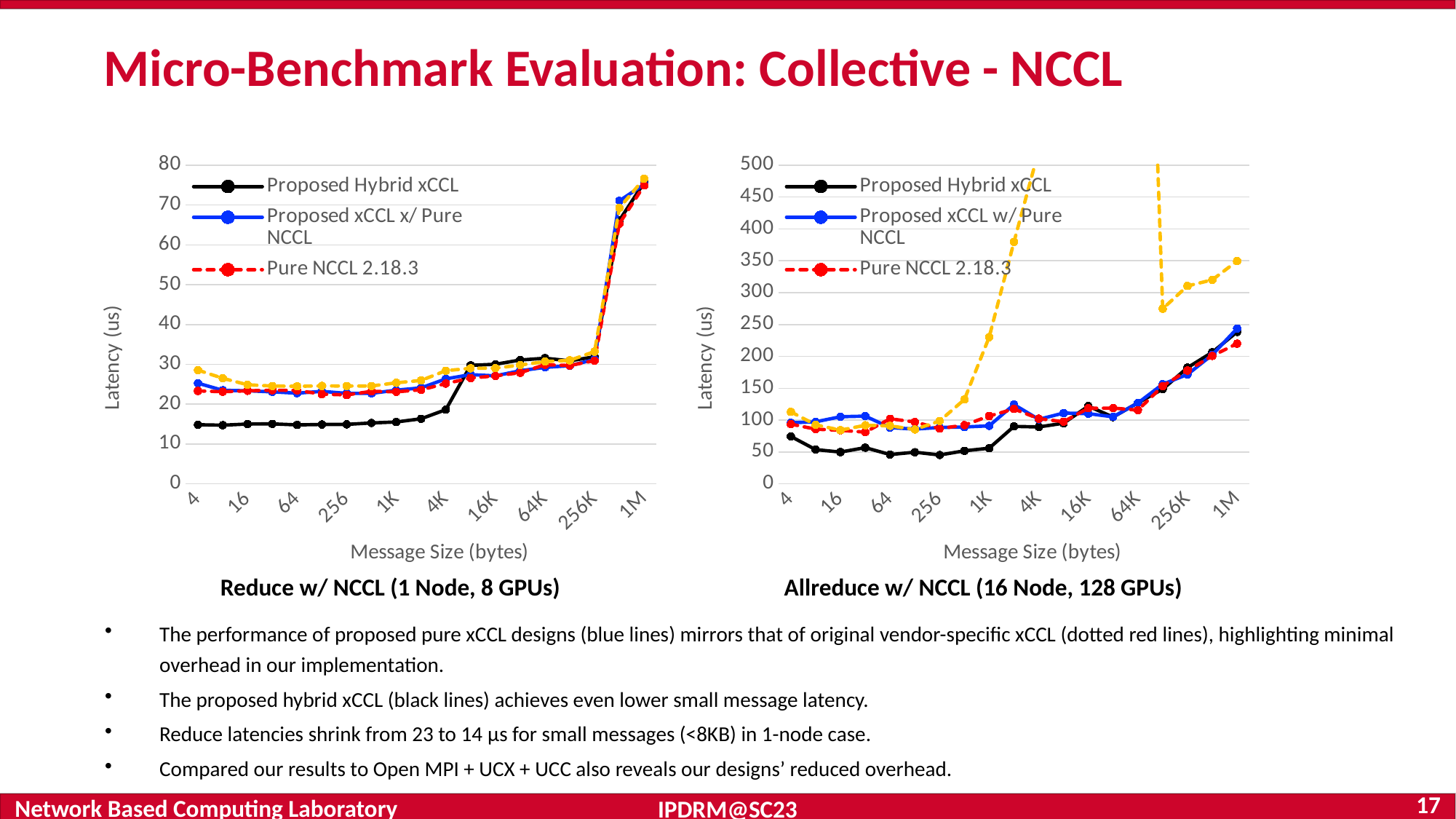
In the Reduce w/ NCCL (1 Node, 8 GPUs) chart, is the latency of Proposed Hybrid xCCL at message size 1M greater or less than 70? greater In the Allreduce w/ NCCL (16 Node, 128 GPUs) chart, does the latency of Pure NCCL 2.18.3 overall rise or fall from message size 4K to 1M? rise In the Allreduce w/ NCCL (16 Node, 128 GPUs) chart, is the latency of Pure NCCL 2.18.3 at message size 1M greater or less than 200? greater In the Reduce w/ NCCL (1 Node, 8 GPUs) chart, which series has the lowest latency at message size 4? Proposed Hybrid xCCL How many series does the legend of the Allreduce w/ NCCL (16 Node, 128 GPUs) chart list? 3 In the Allreduce w/ NCCL (16 Node, 128 GPUs) chart, at message size 256, which is larger: the latency of Proposed Hybrid xCCL or of Pure NCCL 2.18.3? Pure NCCL 2.18.3 What is the y-axis label of the Reduce w/ NCCL (1 Node, 8 GPUs) chart? Latency (us) In the Reduce w/ NCCL (1 Node, 8 GPUs) chart, at message size 64, which is larger: the latency of Pure NCCL 2.18.3 or of Proposed Hybrid xCCL? Pure NCCL 2.18.3 In the Reduce w/ NCCL (1 Node, 8 GPUs) chart, is the latency of Proposed Hybrid xCCL at message size 4 greater or less than 20? less What kind of chart is the Reduce w/ NCCL (1 Node, 8 GPUs) chart? line chart